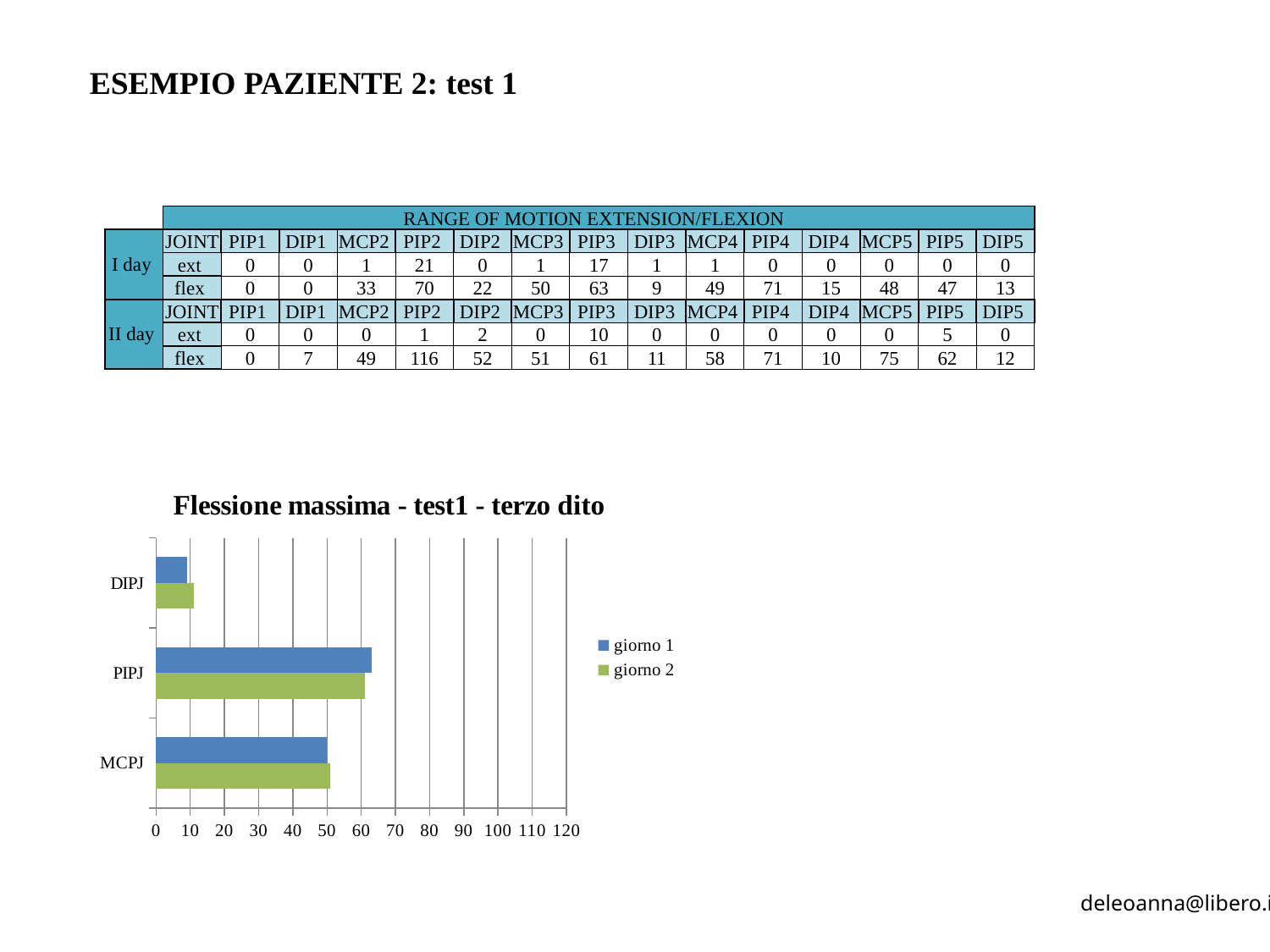
How many categories are shown on the chart's vertical axis? 3 What is the title of the chart? Flessione massima - test1 - terzo dito How many series does the chart legend list? 2 Is the giorno 1 value for DIPJ greater or less than 20? less Is the giorno 2 value for PIPJ greater or less than 50? greater Is the giorno 2 value for MCPJ greater or less than 40? greater What are the two series named in the chart legend? giorno 1, giorno 2 Which category has the highest value for giorno 1? PIPJ For giorno 1, which is larger: PIPJ or MCPJ? PIPJ What kind of chart is shown on the slide? bar chart Which category has the lowest value for giorno 2? DIPJ